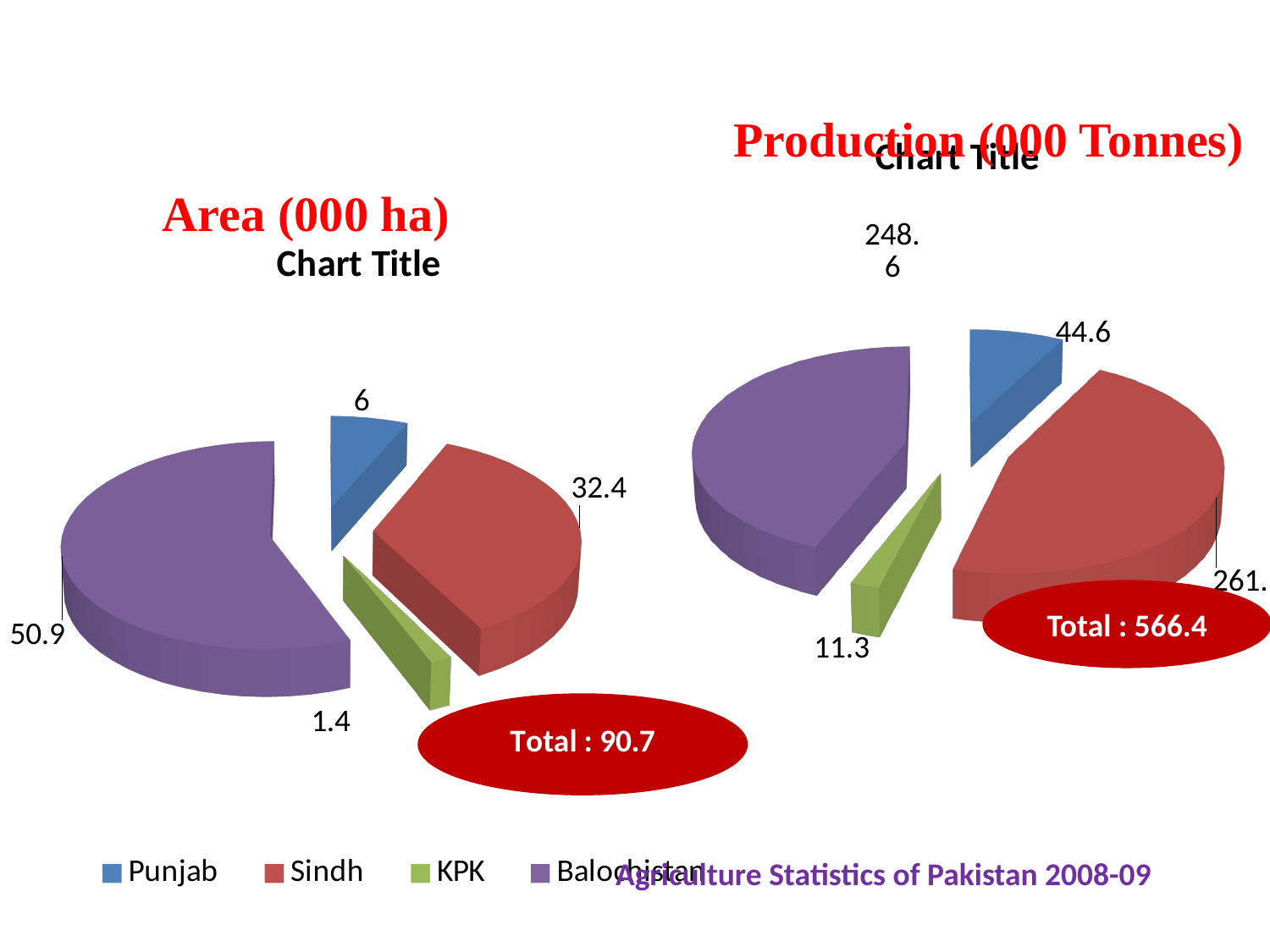
In the Area (000 ha) chart, which province has the largest slice? Balochistan In the Area (000 ha) chart, what is the difference between the values for Balochistan and Sindh? 18.5 In the Area (000 ha) chart, what is the value for Sindh? 32.4 In the Production (000 Tonnes) chart, which province has the smallest slice? KPK In the Area (000 ha) chart, which is larger, the value for Punjab or the value for KPK? Punjab In the Area (000 ha) chart, what is the value for Balochistan? 50.9 What kind of chart is the Area (000 ha) chart? pie chart What total is shown for the Area (000 ha) chart? 90.7 What total is shown for the Production (000 Tonnes) chart? 566.4 In the Production (000 Tonnes) chart, what is the value for KPK? 11.3 In the Production (000 Tonnes) chart, what is the value for Punjab? 44.6 In the Area (000 ha) chart, which province has the smallest slice? KPK